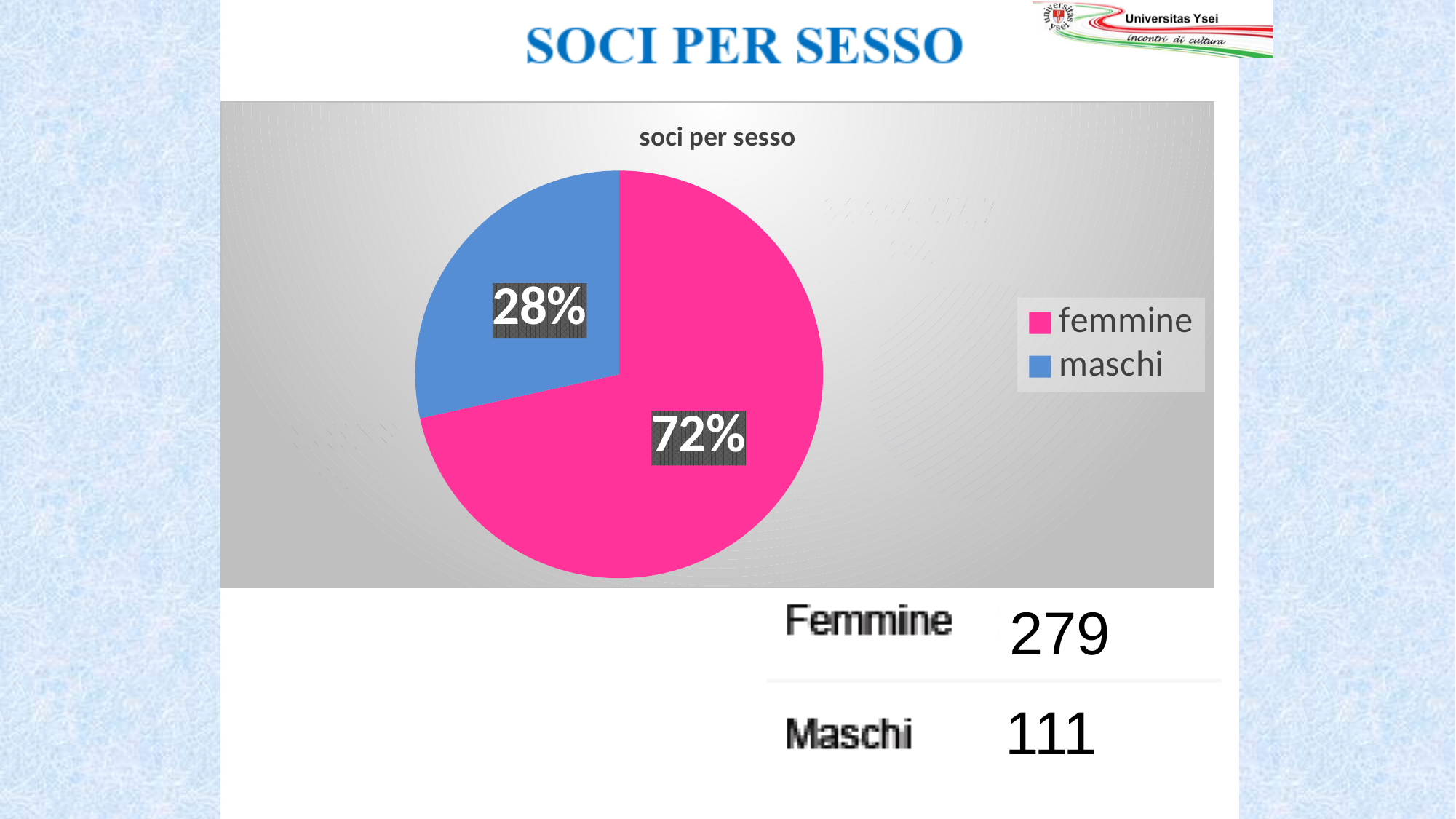
According to the table below the chart, how many Femmine are there? 279 What share of the pie does the maschi slice represent? 28% What kind of chart is shown on the slide? pie chart What colour is the femmine slice? pink How many slices does the pie chart have? 2 What is the title of the chart? soci per sesso Which slice is larger, femmine or maschi? femmine Which category has the largest slice of the pie? femmine How many entries does the legend list? 2 What is the difference in percentage points between the femmine and maschi slices? 44 Which category has the smallest slice of the pie? maschi What share of the pie does the femmine slice represent? 72%